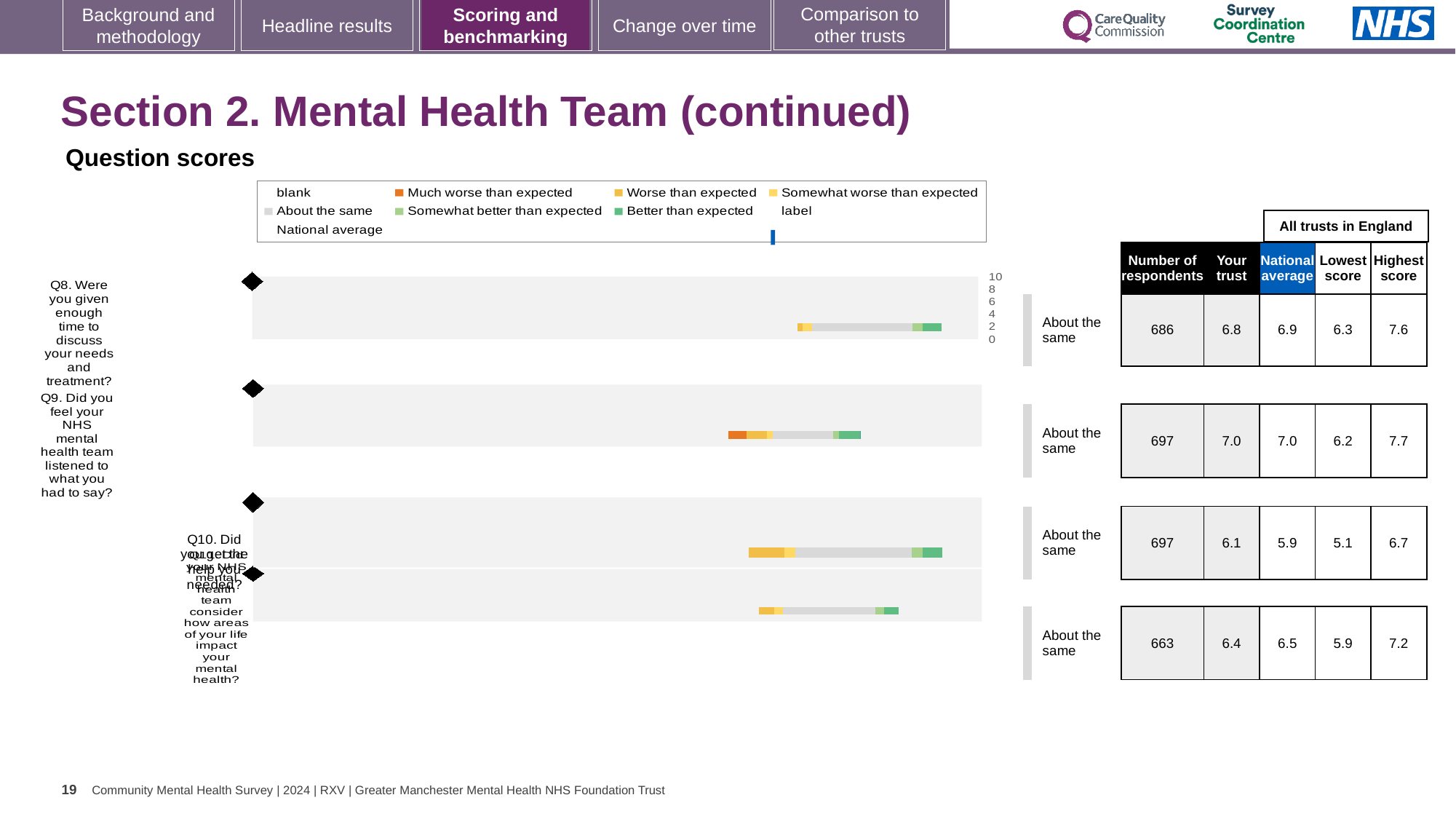
What kind of chart is used to show the question scores on this slide? bar chart What is the difference between the national average and the 'Your trust' score for Q8? 0.1 What is the 'Your trust' score for Q9 in the table beside the chart? 7.0 What is the highest score across all trusts in England for Q8? 7.6 How many question bars are plotted in the question scores chart? 4 In the chart legend, which colour represents 'Much worse than expected'? orange In the chart legend, which colour represents 'Better than expected'? green Which question has the lowest 'Your trust' score in the table beside the chart? Q10 According to the table beside the chart, how many respondents answered Q8? 686 Is the 'Your trust' score for Q10 larger or smaller than its national average? larger Which question has the highest 'Your trust' score in the table beside the chart? Q9 What is the national average score for Q10 in the table beside the chart? 5.9